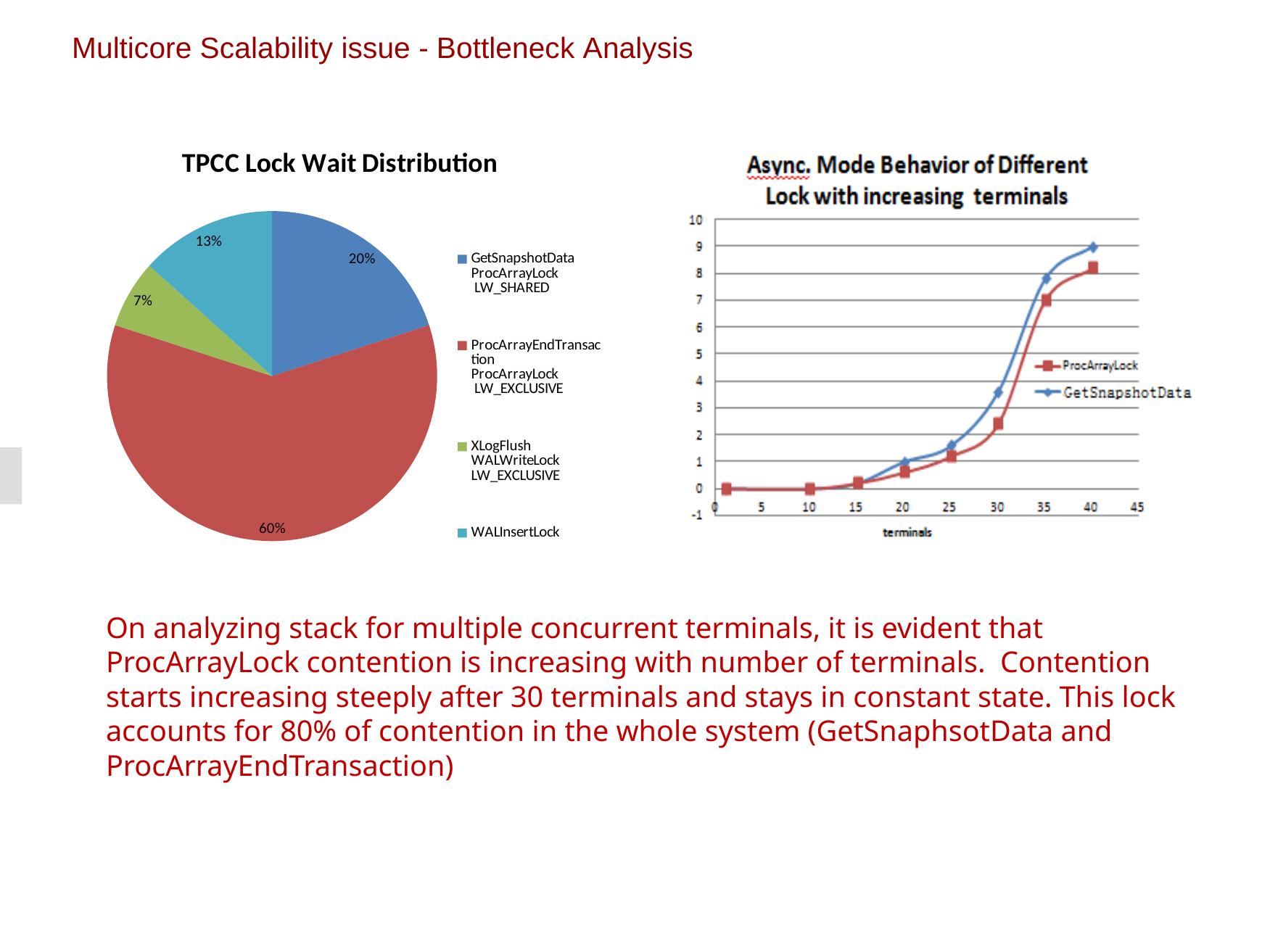
In the TPCC Lock Wait Distribution pie chart, what share does the WALInsertLock slice have? 13% In the TPCC Lock Wait Distribution pie chart, what is the difference between the GetSnapshotData ProcArrayLock LW_SHARED share and the WALInsertLock share? 7% In the TPCC Lock Wait Distribution pie chart, which slice is the largest? ProcArrayEndTransaction ProcArrayLock LW_EXCLUSIVE In the Async. Mode Behavior chart on the right, is the ProcArrayLock value at 30 terminals greater or less than 3? less In the TPCC Lock Wait Distribution pie chart, what share does the ProcArrayEndTransaction ProcArrayLock LW_EXCLUSIVE slice have? 60% In the Async. Mode Behavior chart on the right, is the GetSnapshotData value at 40 terminals greater or less than 8? greater What kind of chart is the TPCC Lock Wait Distribution chart? Pie chart In the Async. Mode Behavior chart on the right, how many series does the legend list? 2 In the TPCC Lock Wait Distribution pie chart, which slice is the smallest? XLogFlush WALWriteLock LW_EXCLUSIVE In the TPCC Lock Wait Distribution pie chart, how many slices are there? 4 In the Async. Mode Behavior chart on the right, do the values rise or fall as the number of terminals increases? Rise In the TPCC Lock Wait Distribution pie chart, what share does the XLogFlush WALWriteLock LW_EXCLUSIVE slice have? 7%